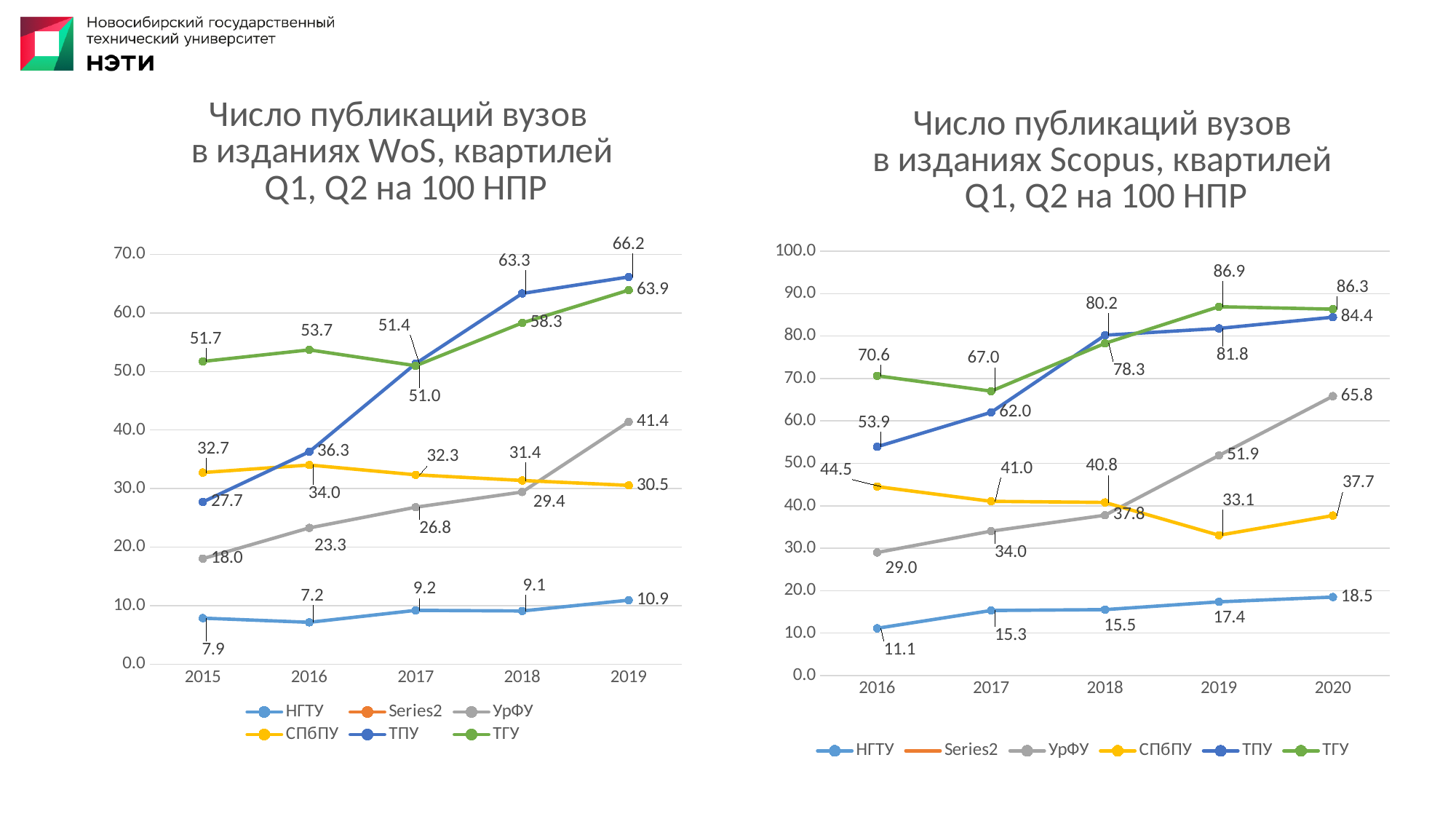
In the right chart (Scopus), what is the value for НГТУ in 2016? 11.1 In the left chart (WoS), which university has the lowest value in 2017? НГТУ What type of chart is the left chart, 'Число публикаций вузов в изданиях WoS, квартилей Q1, Q2 на 100 НПР'? line chart In the right chart (Scopus), what is the difference between the УрФУ values in 2020 and 2016? 36.8 How many series does the legend of the right chart (Scopus) list? 6 In the right chart (Scopus), which is larger in 2018: the value for УрФУ or the value for СПбПУ? СПбПУ In the left chart (WoS), what is the difference between ТПУ and ТГУ in 2018? 5.0 In the left chart (WoS), what is the value for УрФУ in 2015? 18.0 In the right chart (Scopus), what is the value for ТГУ in 2019? 86.9 In the right chart (Scopus), which university has the highest value in 2020? ТГУ In the left chart (WoS), does the value for СПбПУ rise or fall from 2016 to 2019? fall In the left chart (WoS), what is the value for ТПУ in 2019? 66.2